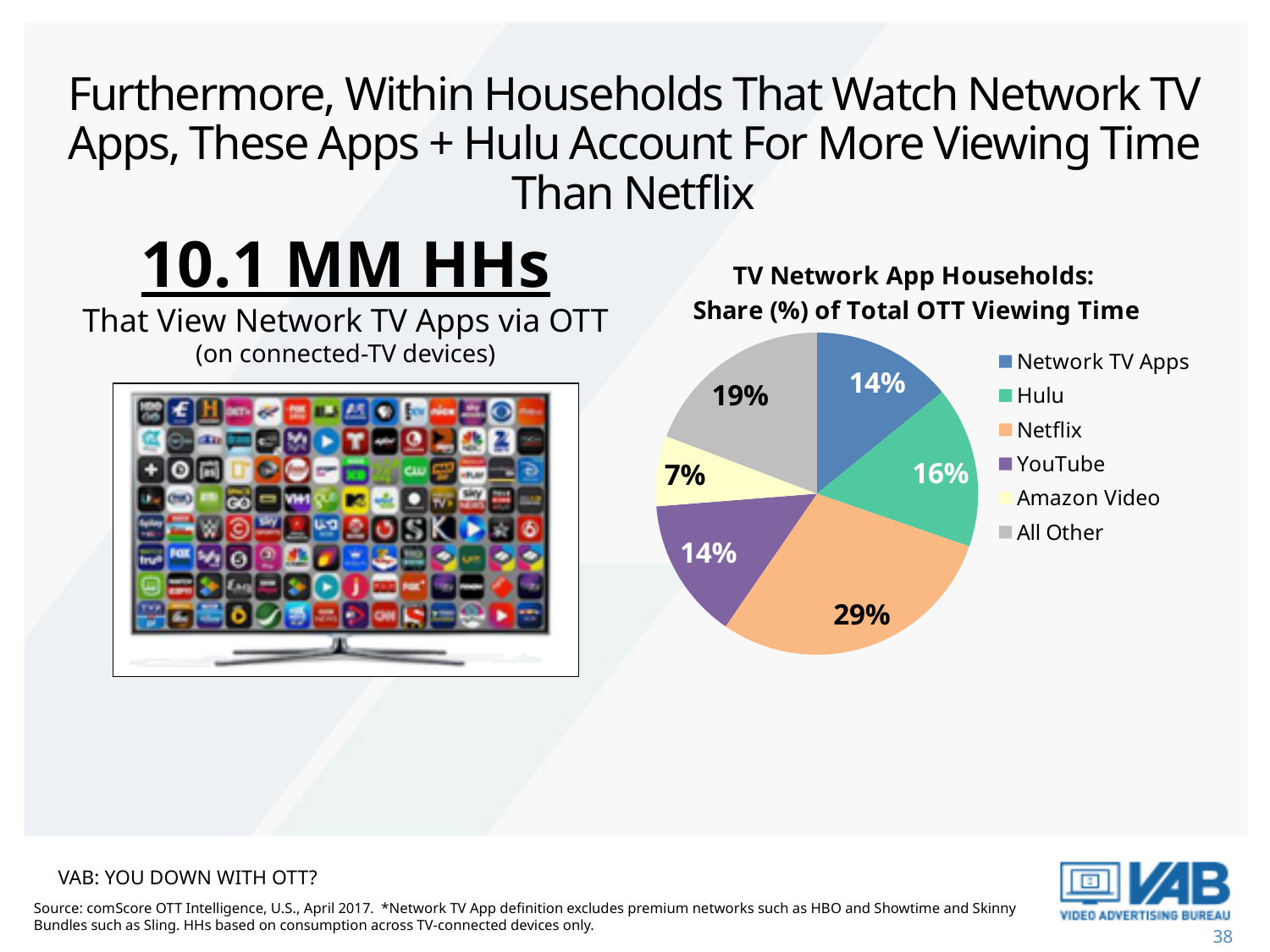
Which category has the largest share of total OTT viewing time in the pie chart? Netflix What share of total OTT viewing time does the All Other slice account for? 19% Which has a larger share of OTT viewing time, Hulu or YouTube? Hulu What is the difference in share between Netflix and Hulu? 13 percentage points What share of total OTT viewing time does Hulu account for? 16% How many slices does the pie chart have? 6 Which category has the smallest share of total OTT viewing time in the pie chart? Amazon Video What is the combined share of Network TV Apps and Hulu? 30% What share of total OTT viewing time does Amazon Video account for? 7% What share of total OTT viewing time does Netflix account for in the pie chart? 29% What is the title of the pie chart? TV Network App Households: Share (%) of Total OTT Viewing Time What type of chart is shown on the slide? Pie chart